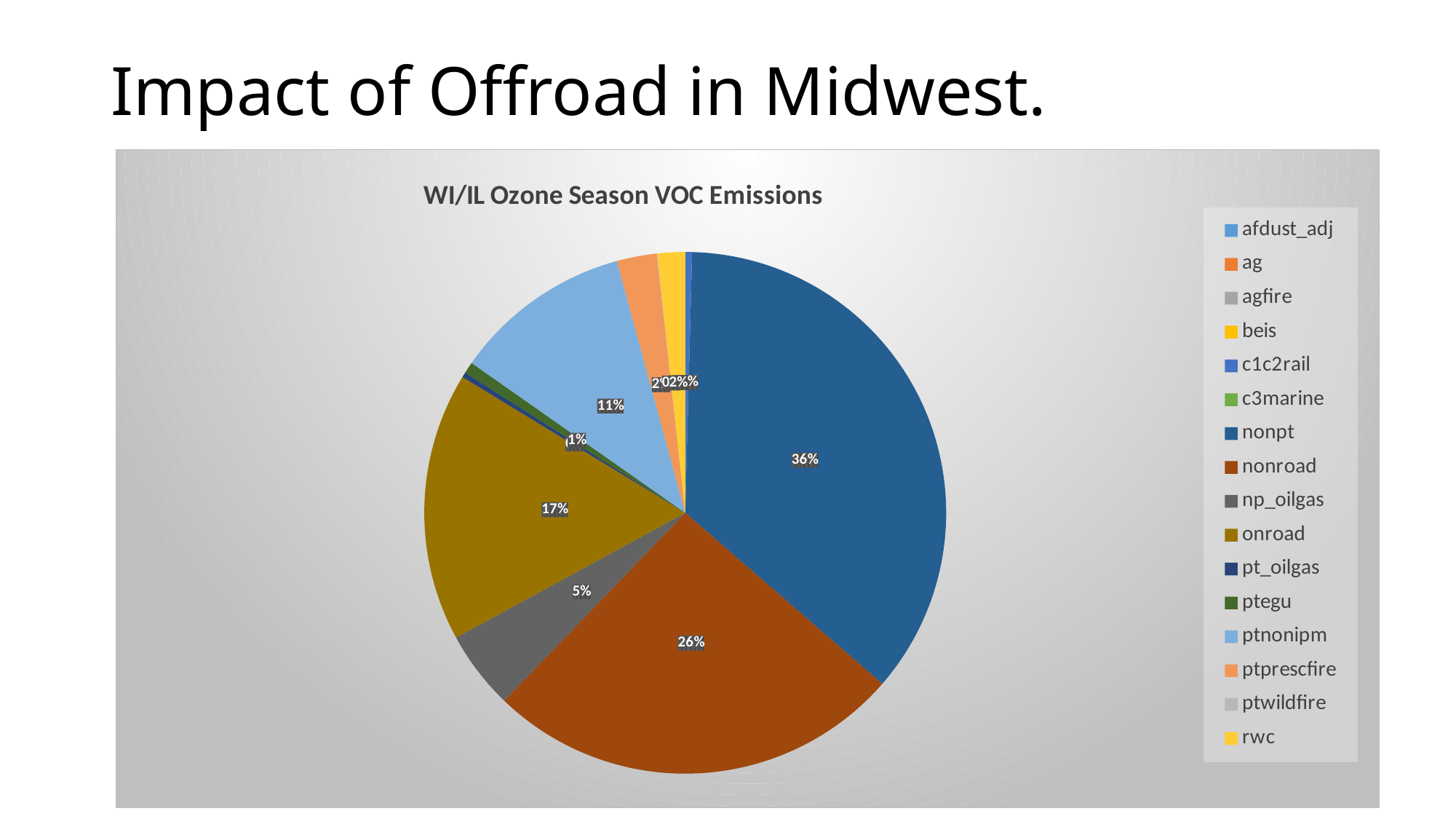
What is the title of the chart? WI/IL Ozone Season VOC Emissions What share of the pie does ptnonipm account for? 11% What share of the pie does np_oilgas account for? 5% Which category has the largest slice of the pie? nonpt How many entries does the chart's legend list? 16 By how many percentage points does the onroad share exceed the ptnonipm share? 6 Which is larger, the nonpt slice or the nonroad slice? nonpt What kind of chart is shown on the slide? pie chart What share of the pie does nonroad account for? 26% By how many percentage points does the nonpt share exceed the nonroad share? 10